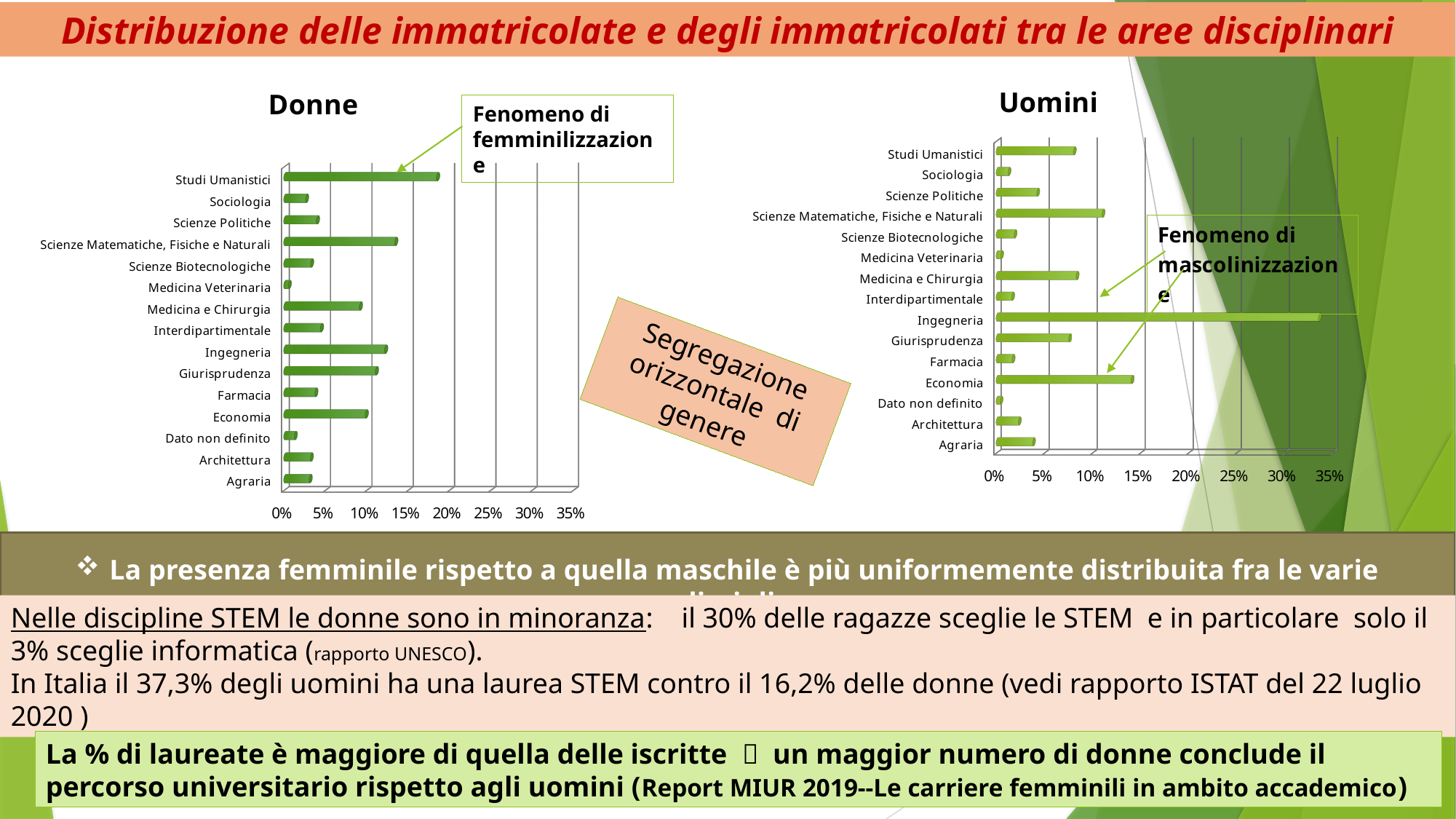
In the "Donne" chart, which disciplinary area has the lowest value? Medicina Veterinaria How many disciplinary areas are listed on the "Uomini" chart? 15 In the "Uomini" chart, which disciplinary area has the highest value? Ingegneria In the "Uomini" chart, which is larger: the value for Scienze Matematiche, Fisiche e Naturali or the value for Studi Umanistici? Scienze Matematiche, Fisiche e Naturali In the "Donne" chart, which disciplinary area has the highest value? Studi Umanistici What kind of chart is the "Donne" chart? bar chart In the "Donne" chart, is the value for Studi Umanistici greater or less than 15%? greater In the "Uomini" chart, is the value for Ingegneria greater or less than 30%? greater What is the title of the chart on the right side of the slide? Uomini In the "Uomini" chart, is the value for Economia greater or less than 10%? greater In the "Donne" chart, which is larger: the value for Ingegneria or the value for Economia? Ingegneria